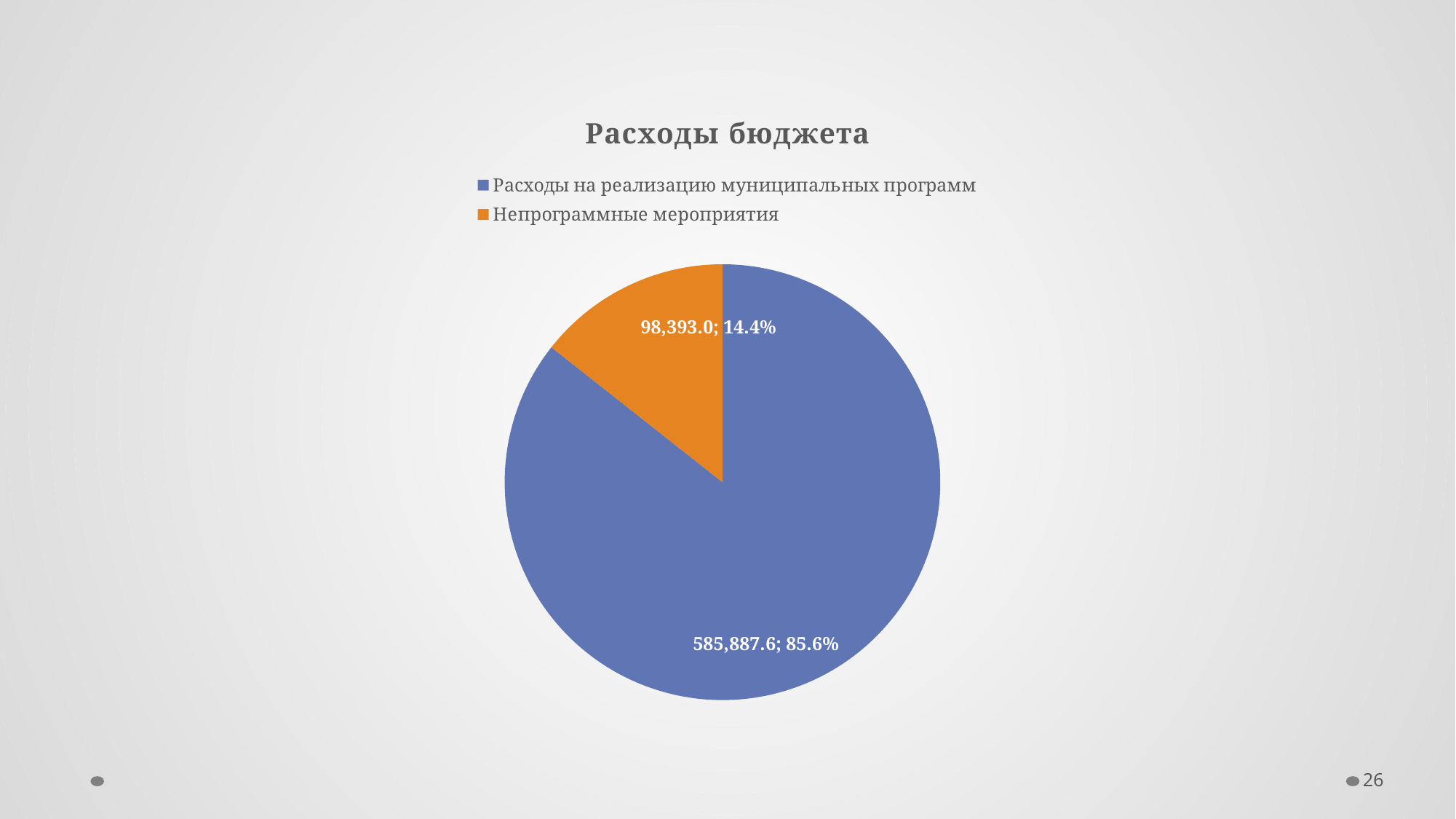
How many slices does the pie chart have? 2 What is the title of the chart? Расходы бюджета What is the difference between the values for Расходы на реализацию муниципальных программ and Непрограммные мероприятия? 487,494.6 What is the value for Непрограммные мероприятия? 98,393.0 What share of the pie does Расходы на реализацию муниципальных программ represent? 85.6% What colour is the slice for Непрограммные мероприятия? orange Which is larger: Непрограммные мероприятия or Расходы на реализацию муниципальных программ? Расходы на реализацию муниципальных программ What share of the pie does Непрограммные мероприятия represent? 14.4% What is the value for Расходы на реализацию муниципальных программ? 585,887.6 What kind of chart is shown on the slide? pie chart Which category has the smallest slice? Непрограммные мероприятия Which category has the largest slice? Расходы на реализацию муниципальных программ